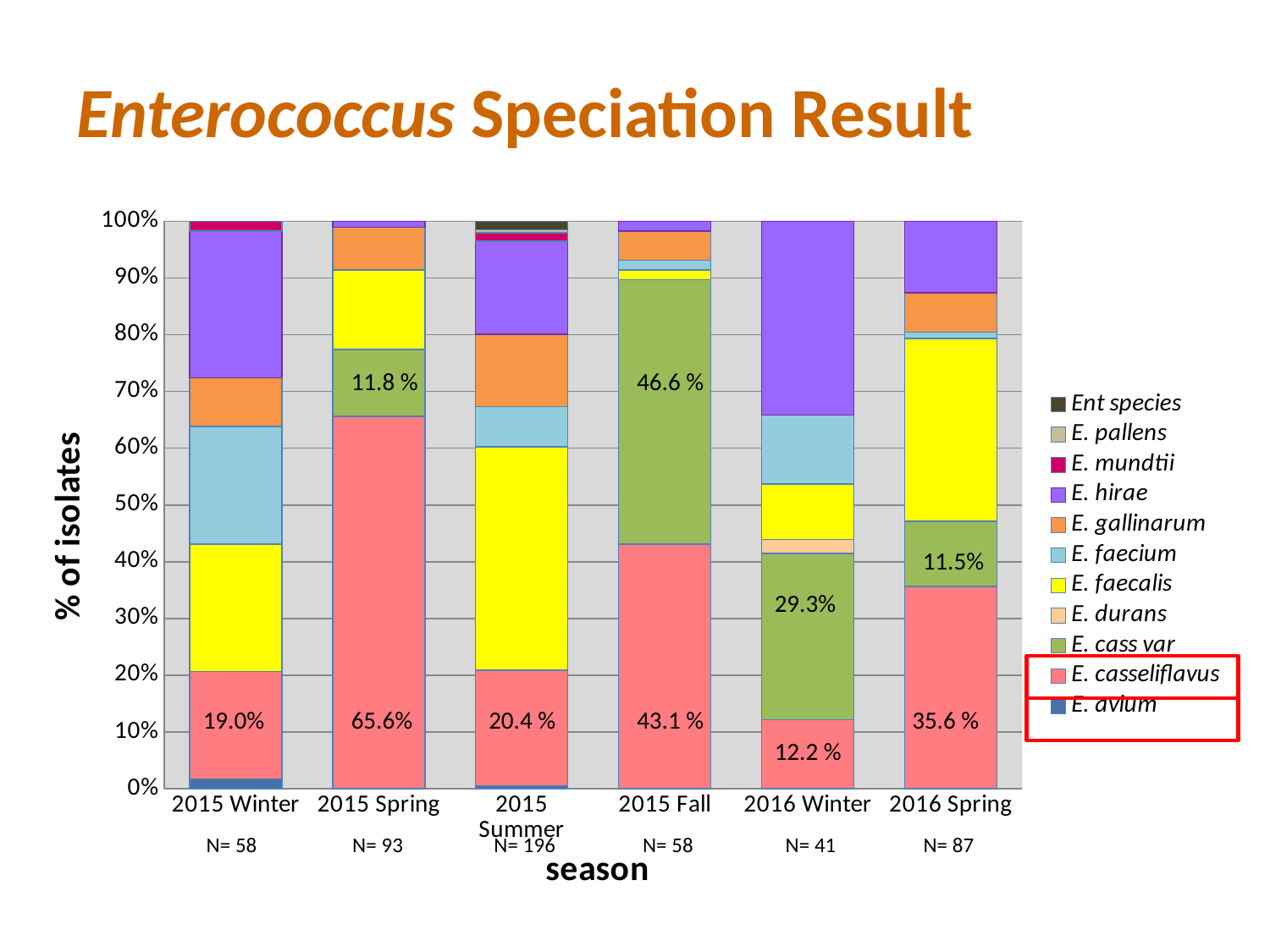
What kind of chart is shown on the slide? Stacked bar chart What is the labelled E. casseliflavus percentage for 2015 Winter? 19.0% Which season has the highest labelled percentage of E. casseliflavus? 2015 Spring How many seasons are shown on the x axis? 6 What is the labelled E. cass var percentage for 2016 Winter? 29.3% Which season has a larger E. cass var percentage, 2015 Fall or 2016 Winter? 2015 Fall What percentage of isolates in 2015 Spring were E. casseliflavus? 65.6% Which season has the lowest labelled percentage of E. casseliflavus? 2016 Winter Is the E. casseliflavus percentage in 2015 Fall greater or less than 40%? greater How many species does the legend list? 11 What is the difference between the E. casseliflavus percentages in 2015 Spring and 2016 Winter? 53.4% What percentage of isolates in 2015 Fall were E. cass var? 46.6 %